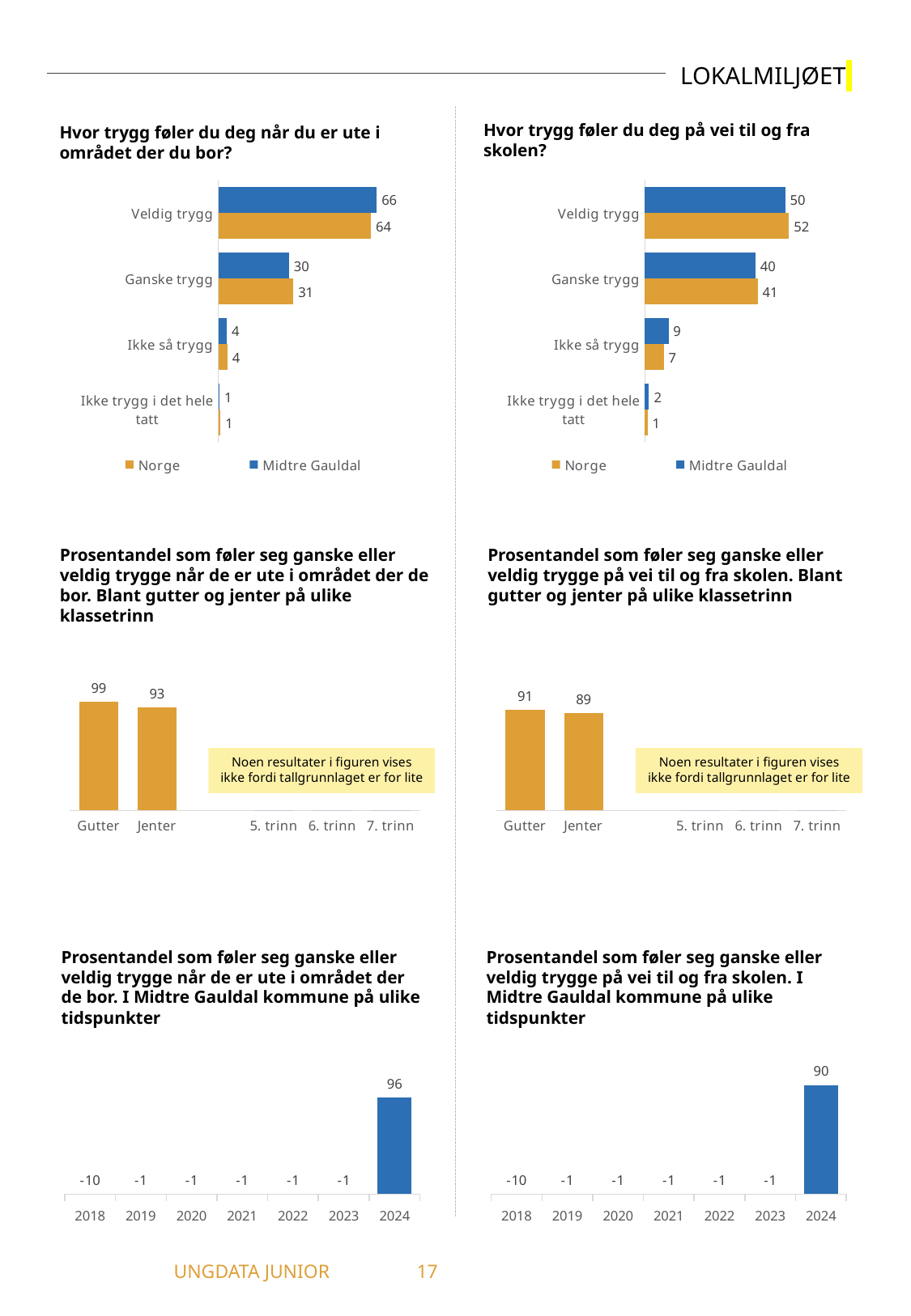
In the chart 'Hvor trygg føler du deg når du er ute i området der du bor?', what is the value for Midtre Gauldal for 'Veldig trygg'? 66 In the chart 'Hvor trygg føler du deg på vei til og fra skolen?', what is the difference between Midtre Gauldal and Norge for 'Ikke så trygg'? 2 What kind of chart is 'Hvor trygg føler du deg når du er ute i området der du bor?'? Bar chart In the chart 'Prosentandel som føler seg ganske eller veldig trygge på vei til og fra skolen. Blant gutter og jenter på ulike klassetrinn', which is larger, Gutter or Jenter? Gutter In the chart 'Hvor trygg føler du deg på vei til og fra skolen?', which category has the highest value for Midtre Gauldal? Veldig trygg In the chart 'Prosentandel som føler seg ganske eller veldig trygge på vei til og fra skolen. I Midtre Gauldal kommune på ulike tidspunkter', what is the value for 2024? 90 In the chart 'Prosentandel som føler seg ganske eller veldig trygge når de er ute i området der de bor. I Midtre Gauldal kommune på ulike tidspunkter', what is the value for 2024? 96 In the chart 'Prosentandel som føler seg ganske eller veldig trygge når de er ute i området der de bor. Blant gutter og jenter på ulike klassetrinn', what is the value for Gutter? 99 In the chart 'Hvor trygg føler du deg når du er ute i området der du bor?', how many series does the legend list? 2 In the chart 'Hvor trygg føler du deg når du er ute i området der du bor?', what is the value for Norge for 'Ganske trygg'? 31 In the chart 'Hvor trygg føler du deg på vei til og fra skolen?', what is the value for Norge for 'Veldig trygg'? 52 In the chart 'Hvor trygg føler du deg på vei til og fra skolen?', how many categories are shown? 4